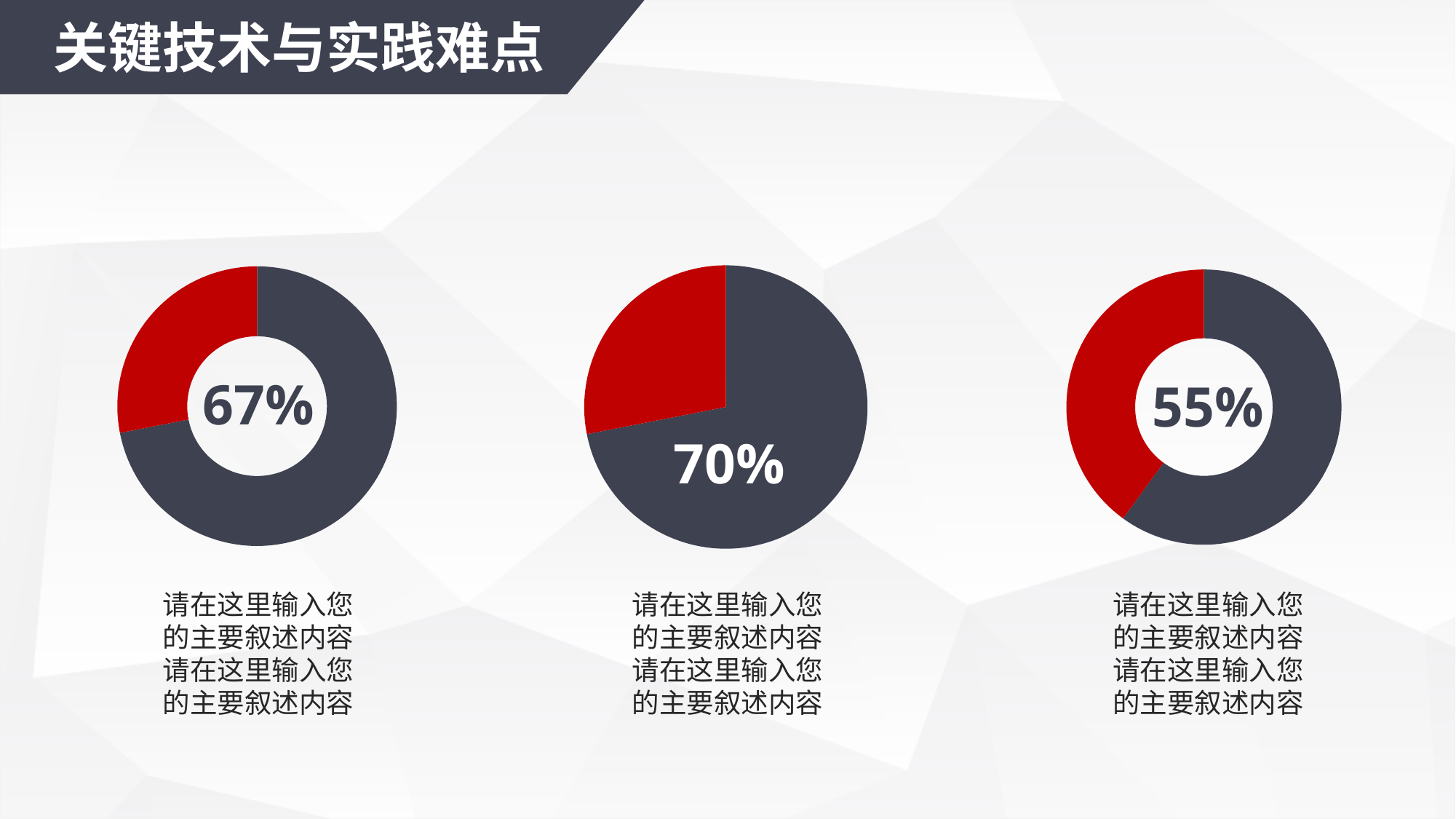
What kind of chart is the middle chart? Pie chart What percentage is shown in the centre of the left doughnut chart? 67% What percentage is shown in the centre of the right doughnut chart? 55% Which of the three charts shows the lowest percentage? The right chart (55%) What percentage is printed on the middle pie chart? 70% Which of the three charts shows the highest percentage? The middle chart (70%) What is the difference between the percentage on the left chart and the percentage on the right chart? 12 percentage points Which shows a larger percentage, the left chart or the right chart? The left chart (67%) How many charts are on the slide? 3 What is the difference between the percentage on the middle chart and the percentage on the left chart? 3 percentage points In the middle pie chart, what colour is the larger slice? Dark grey How many slices does the left doughnut chart have? 2